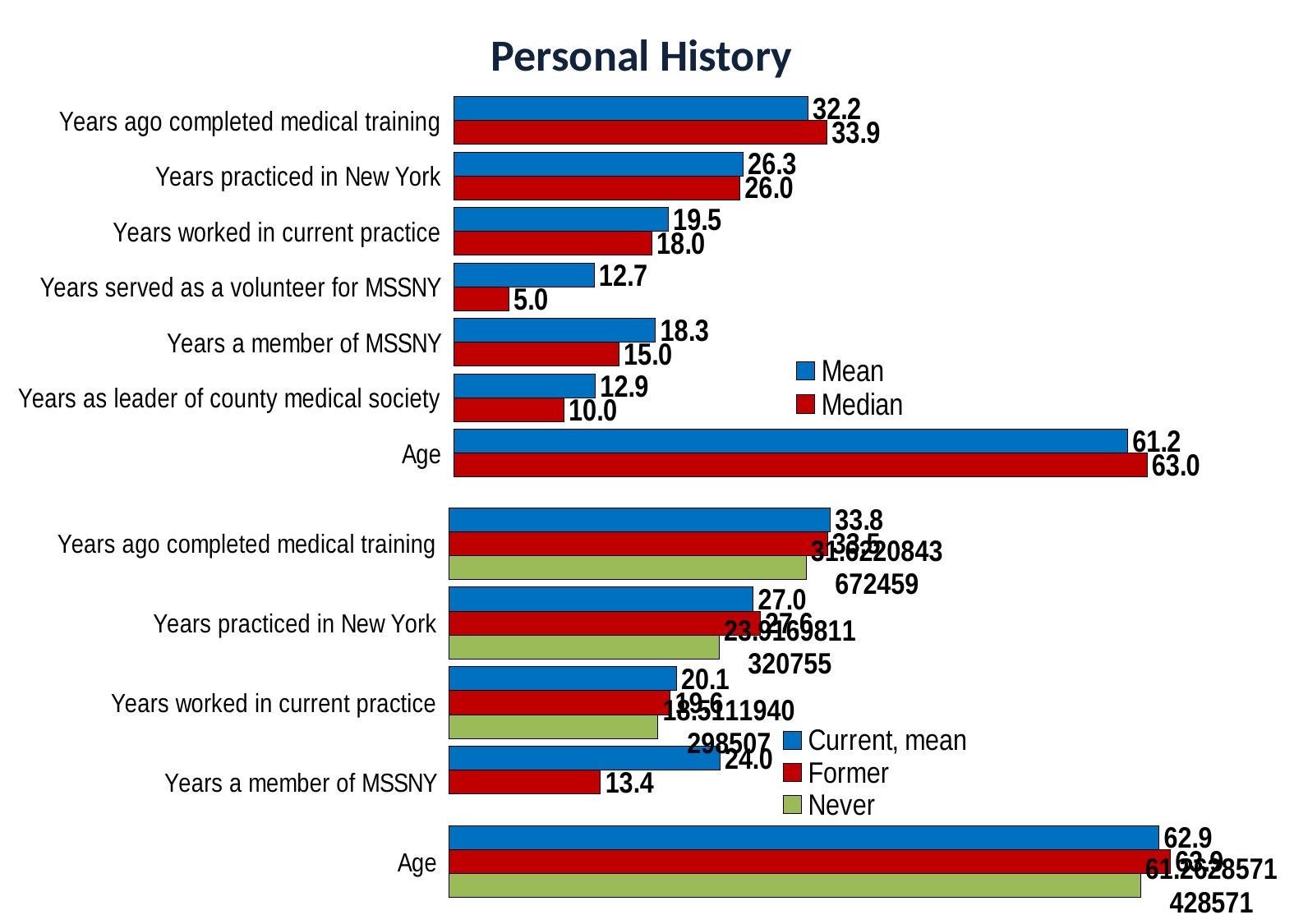
How many categories are shown in the top chart? 7 How many series does the legend of the bottom chart list? 3 What kind of chart is the top chart on the slide? Bar chart In the top chart, for 'Years practiced in New York', which is larger, the Mean or the Median? Mean How many series does the legend of the top chart list? 2 In the bottom chart, what is the 'Current, mean' value for 'Years a member of MSSNY'? 24.0 In the top chart, which category has the highest Mean value? Age In the top chart, what is the Median value for 'Years served as a volunteer for MSSNY'? 5.0 In the top chart, which category has the lowest Median value? Years served as a volunteer for MSSNY In the bottom chart, what is the difference between the 'Current, mean' and 'Former' values for 'Years a member of MSSNY'? 10.6 In the top chart, what is the Mean value for 'Years ago completed medical training'? 32.2 In the top chart, what is the difference between the Median and Mean values for 'Age'? 1.8